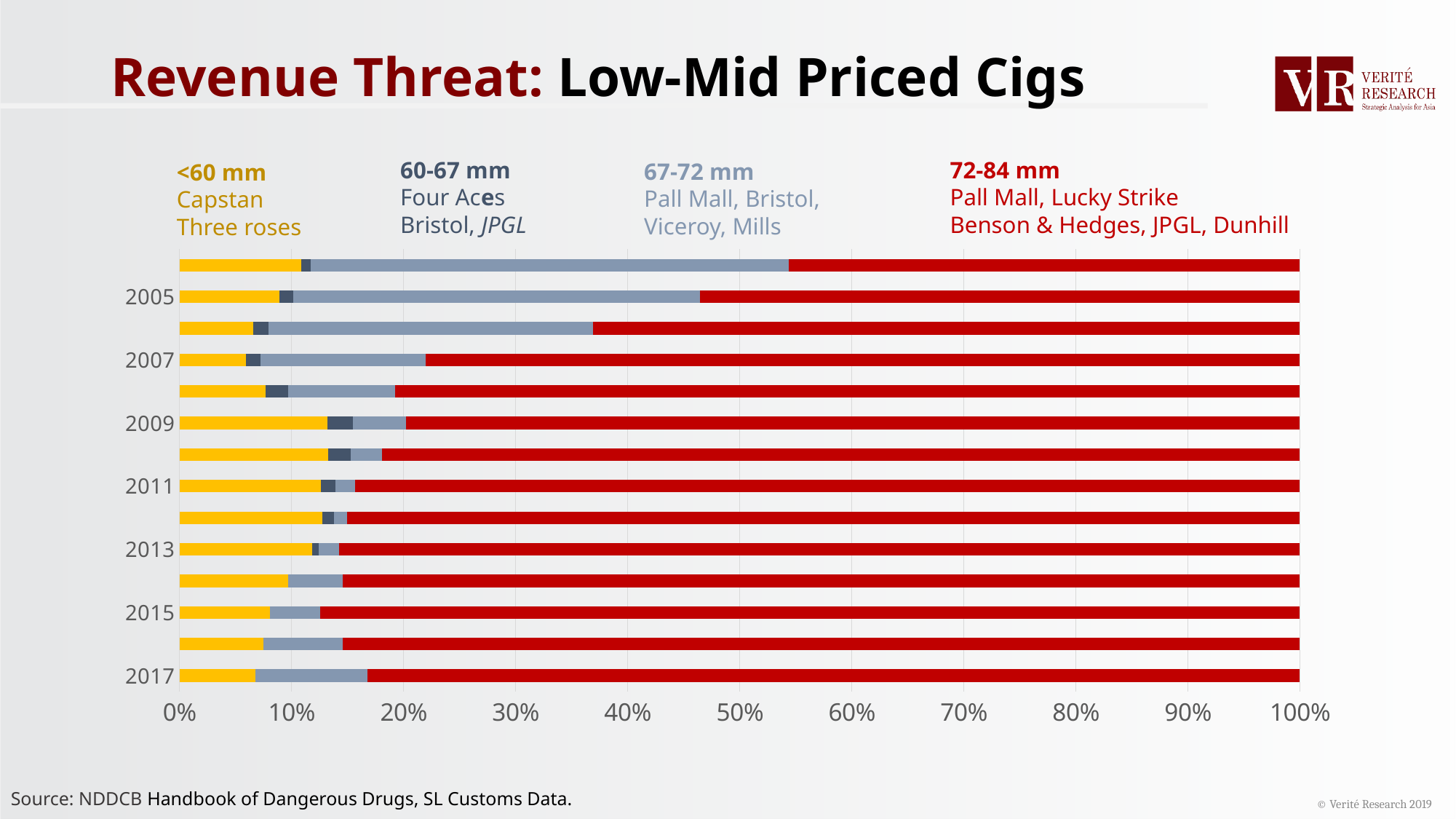
How many cigarette length categories (series) does the chart show? 4 Is the share of 72-84 mm cigarettes in 2005 greater or less than 50%? greater What kind of chart is shown on the slide? Stacked bar chart Is the share of 67-72 mm cigarettes in 2005 greater or less than 30%? greater Is the share of <60 mm cigarettes in 2017 greater or less than 10%? less What colour represents the 72-84 mm category in the chart? Red What is the total of each stacked bar in the chart? 100% Does the share of 67-72 mm cigarettes rise or fall from 2005 to 2017? fall Which brands are listed under the <60 mm category? Capstan, Three roses Which year has the larger share of 72-84 mm cigarettes, 2005 or 2017? 2017 How many years are labelled on the vertical axis of the chart? 7